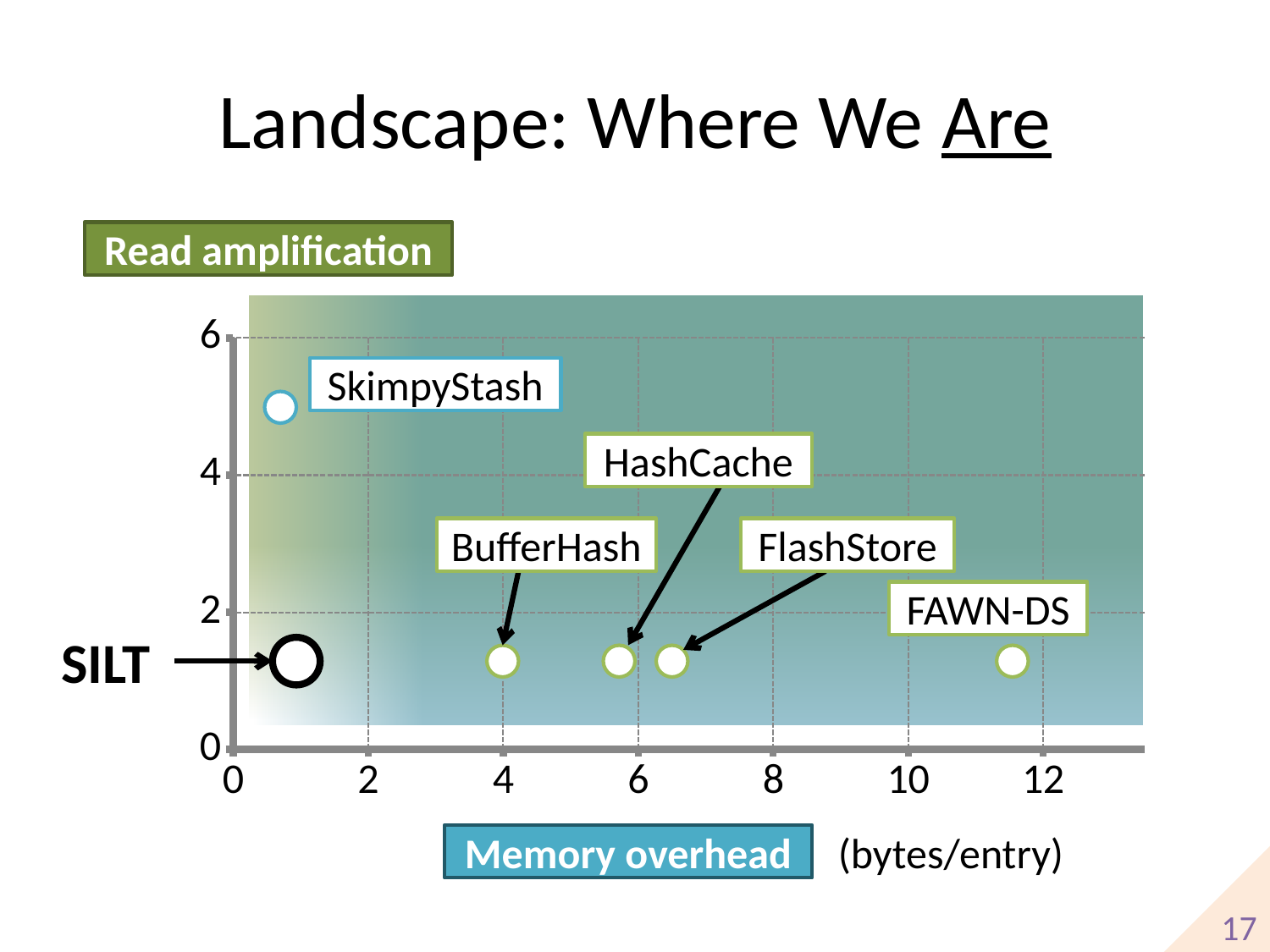
Which has a higher memory overhead, FAWN-DS or BufferHash? FAWN-DS Is the read amplification for SILT greater or less than 2? less How many systems are plotted as points on the chart? 6 What quantity is plotted on the x axis? Memory overhead (bytes/entry) Is the read amplification for SkimpyStash greater or less than 4? greater Is the memory overhead for BufferHash greater or less than 6 bytes/entry? less What quantity is plotted on the y axis? Read amplification Which system has the highest read amplification? SkimpyStash Which system has the highest memory overhead? FAWN-DS What kind of chart is shown on the slide? scatter chart